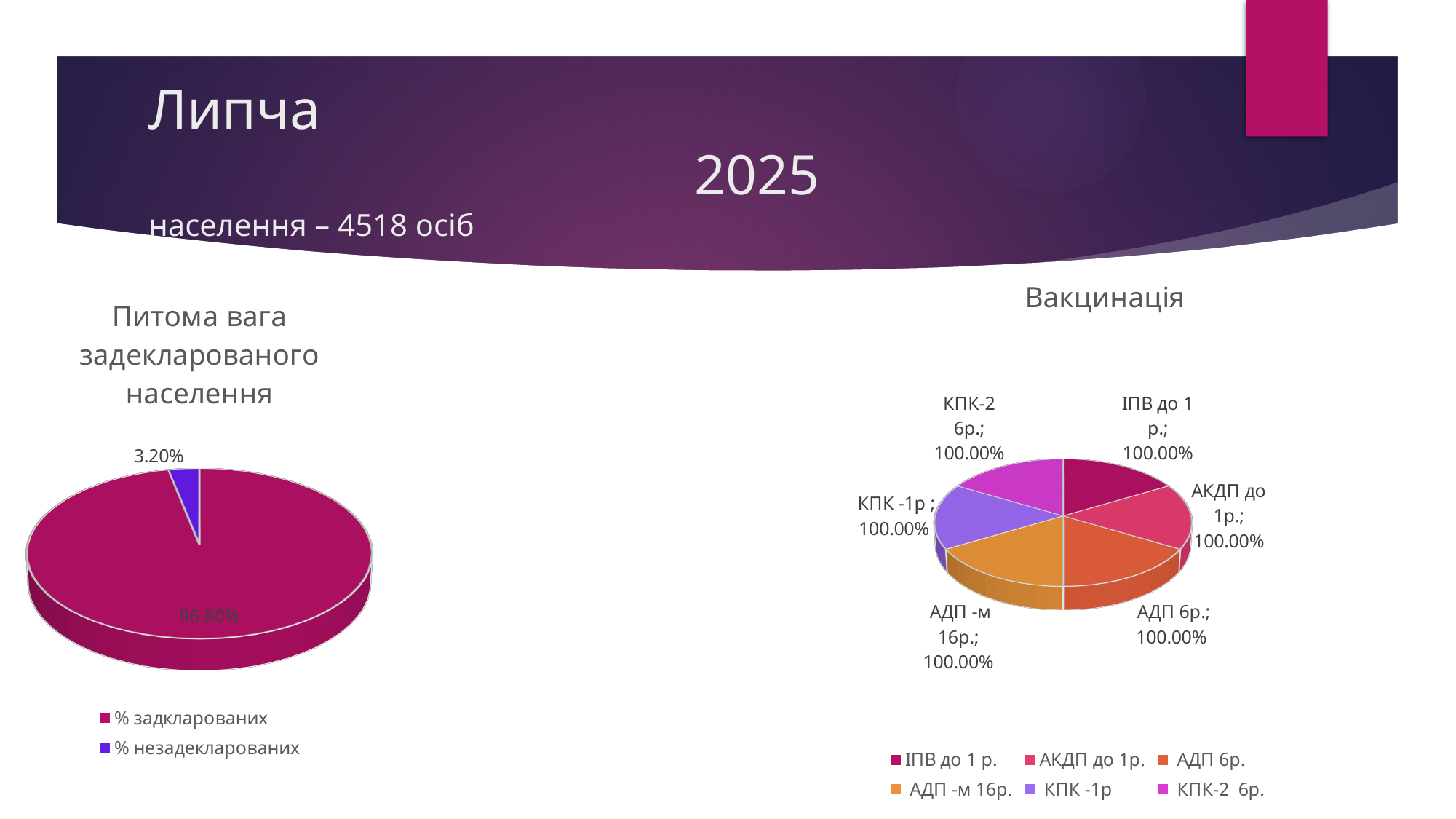
In the chart titled "Вакцинація", what is the value for "КПК -1р"? 100.00% In the chart titled "Питома вага задекларованого населення", which category has the smallest slice? % незадекларованих How many categories does the legend of the chart titled "Вакцинація" list? 6 In the chart titled "Питома вага задекларованого населення", which category has the largest slice? % задкларованих In the chart titled "Вакцинація", what colour is the slice for "АДП -м 16р."? Orange In the chart titled "Питома вага задекларованого населення", what is the value for "% незадекларованих"? 3.20% In the chart titled "Питома вага задекларованого населення", what is the difference between the two slice values? 93.60% How many categories does the legend of the chart titled "Питома вага задекларованого населення" list? 2 In the chart titled "Вакцинація", what is the value for "АДП 6р."? 100.00% What kind of chart is the one titled "Питома вага задекларованого населення"? Pie chart What kind of chart is the one titled "Вакцинація"? Pie chart In the chart titled "Питома вага задекларованого населення", what is the value for "% задкларованих"? 96.80%